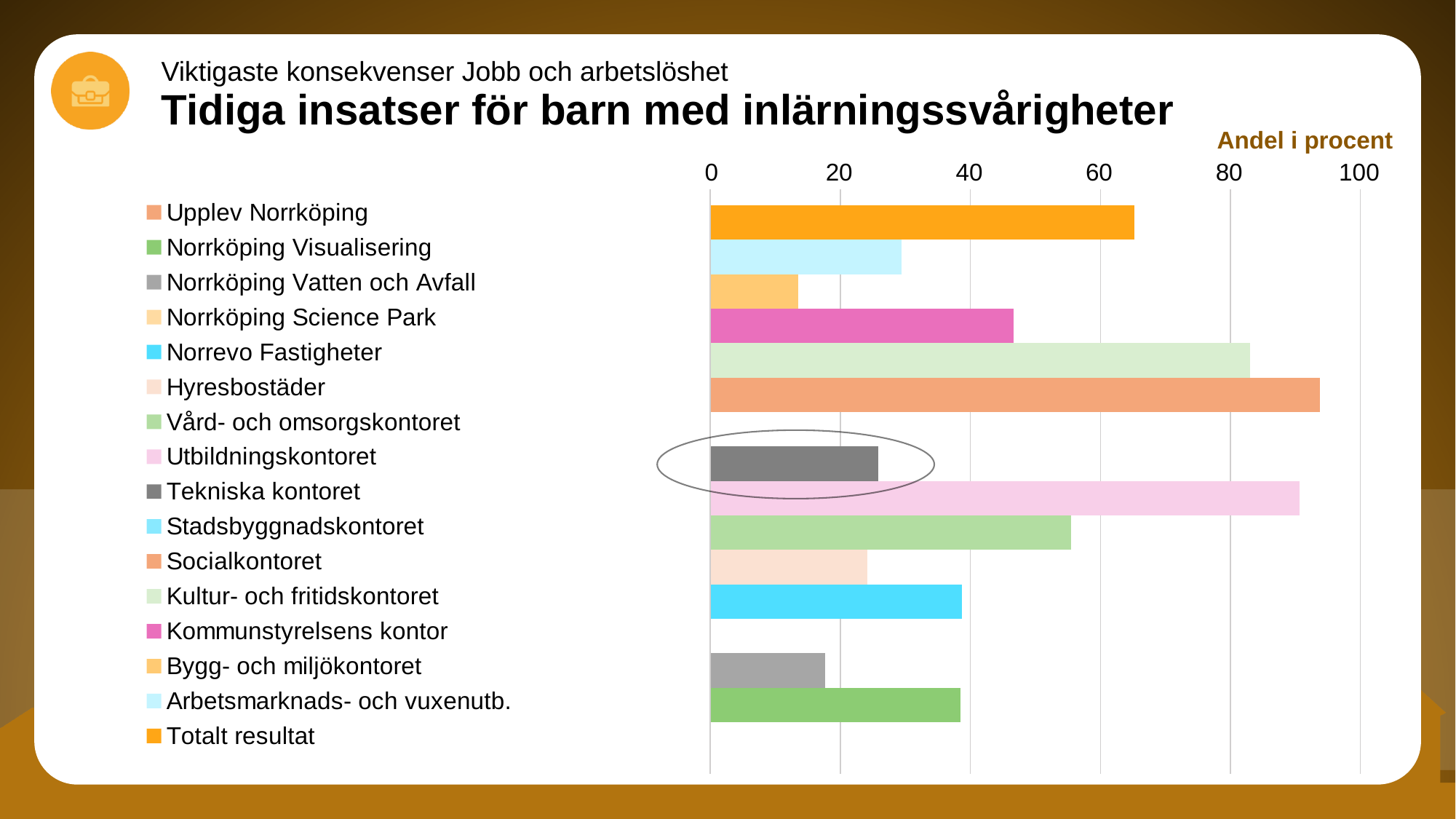
Is the value for Arbetsmarknads- och vuxenutb. greater or less than 40? less Which has the larger value, Totalt resultat or Vård- och omsorgskontoret? Totalt resultat Is the value for Totalt resultat greater or less than 60? greater Is the value for Vård- och omsorgskontoret greater or less than 60? less Which has the larger value, Kultur- och fritidskontoret or Kommunstyrelsens kontor? Kultur- och fritidskontoret What kind of chart is shown on the slide? bar chart How many entries does the chart's legend list? 16 What is the label shown above the horizontal axis of the chart? Andel i procent Which legend entry's bar is circled on the chart? Tekniska kontoret